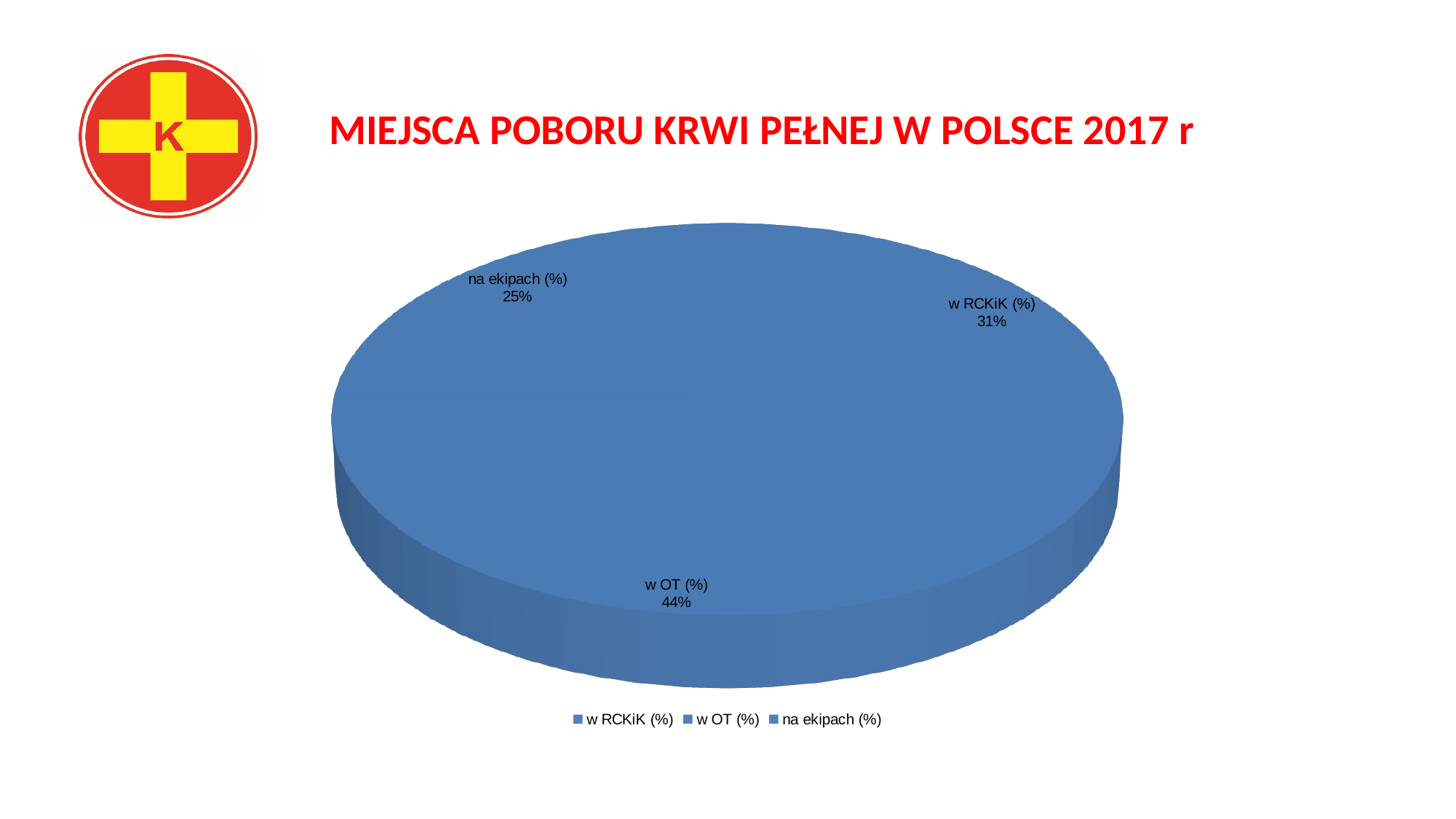
Which category has the largest share of the pie? w OT (%) How many entries does the legend list? 3 What is the difference between the shares of w OT (%) and w RCKiK (%)? 13% What is the value for w RCKiK (%)? 31% Which is larger, the share of w RCKiK (%) or na ekipach (%)? w RCKiK (%) How many categories does the pie chart have? 3 What kind of chart is shown on the slide? pie chart What is the title of the slide containing the chart? MIEJSCA POBORU KRWI PEŁNEJ W POLSCE 2017 r Which category has the smallest share of the pie? na ekipach (%) What is the value for na ekipach (%)? 25% What is the value for w OT (%)? 44% What is the difference between the shares of w RCKiK (%) and na ekipach (%)? 6%